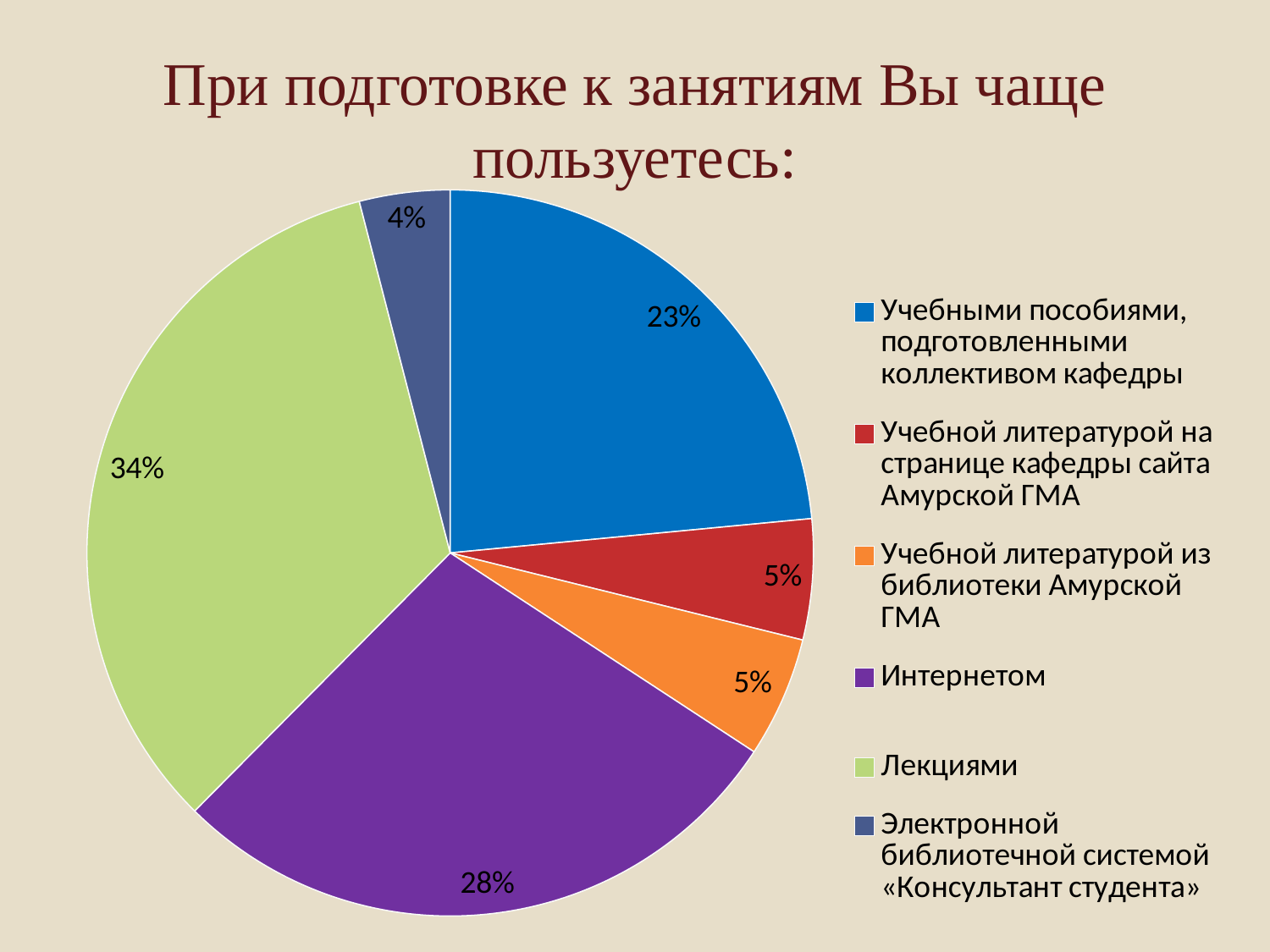
What share of the pie is labelled for "Учебными пособиями, подготовленными коллективом кафедры"? 23% Which category has the largest slice of the pie? Лекциями How many categories does the legend list? 6 What is the difference in percentage points between the slices for "Лекциями" and "Интернетом"? 6 What kind of chart is shown on the slide? pie chart What share of the pie is labelled for "Электронной библиотечной системой «Консультант студента»"? 4% What share of the pie is labelled for "Лекциями"? 34% Which slice is larger: "Интернетом" or "Учебными пособиями, подготовленными коллективом кафедры"? Интернетом Which category has the smallest slice of the pie? Электронной библиотечной системой «Консультант студента» What share of the pie is labelled for "Учебной литературой из библиотеки Амурской ГМА"? 5% What share of the pie is labelled for "Интернетом"? 28% What colour is the slice for "Интернетом"? purple